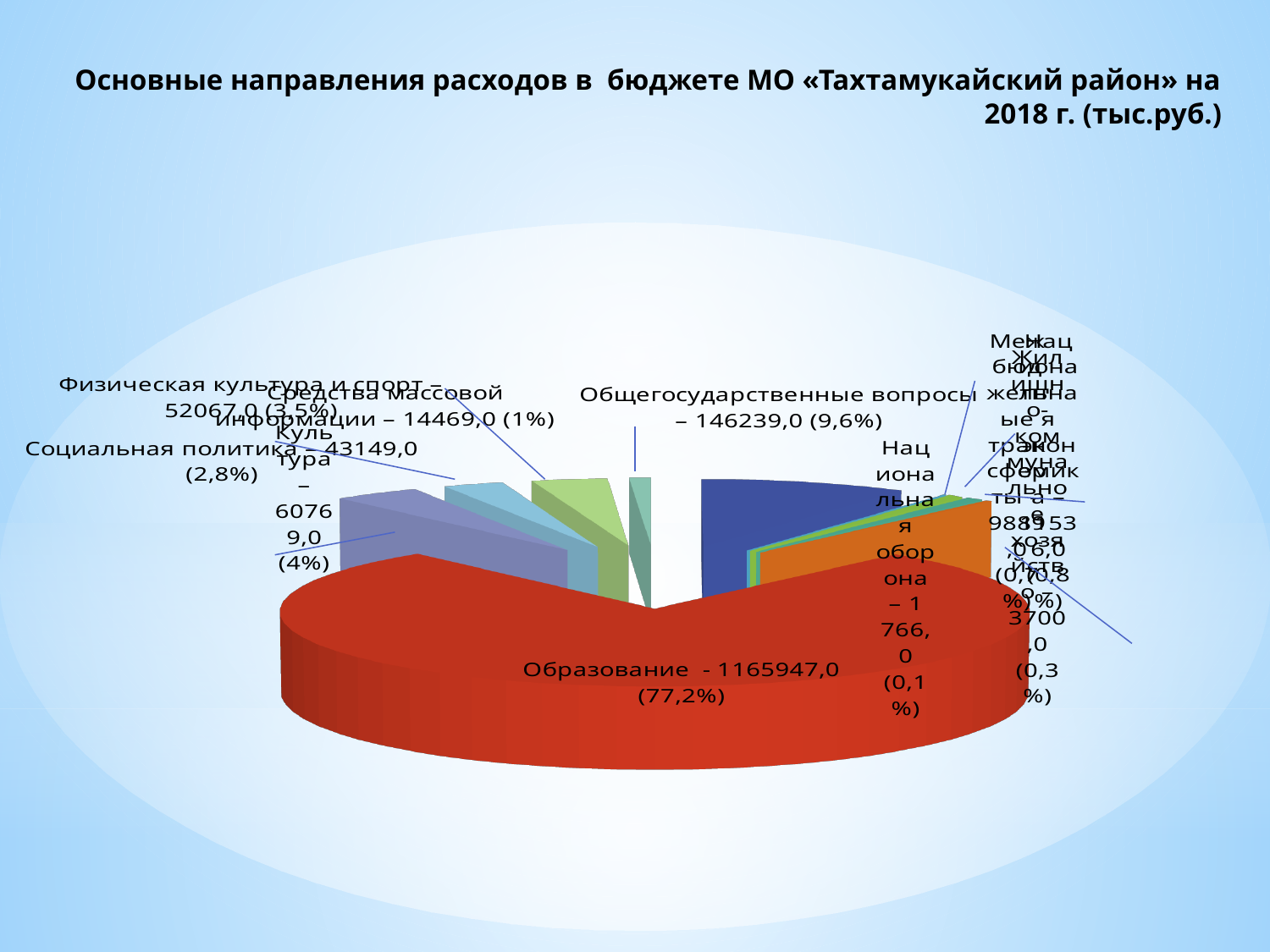
What is the value shown for Физическая культура и спорт? 52067,0 What is the difference between the values for Образование and Общегосударственные вопросы? 1019708,0 What is the difference between the values for Культура and Физическая культура и спорт? 8702,0 What kind of chart is shown on the slide? pie chart What is the value shown for Образование? 1165947,0 What share of the pie does Общегосударственные вопросы represent? 9,6% What share of the pie does Образование represent? 77,2% What is the value shown for Общегосударственные вопросы? 146239,0 What is the title of the chart? Основные направления расходов в бюджете МО «Тахтамукайский район» на 2018 г. (тыс.руб.) What share of the pie does Культура represent? 4% Which is larger, Физическая культура и спорт or Социальная политика? Физическая культура и спорт Which category has the largest slice of the pie? Образование